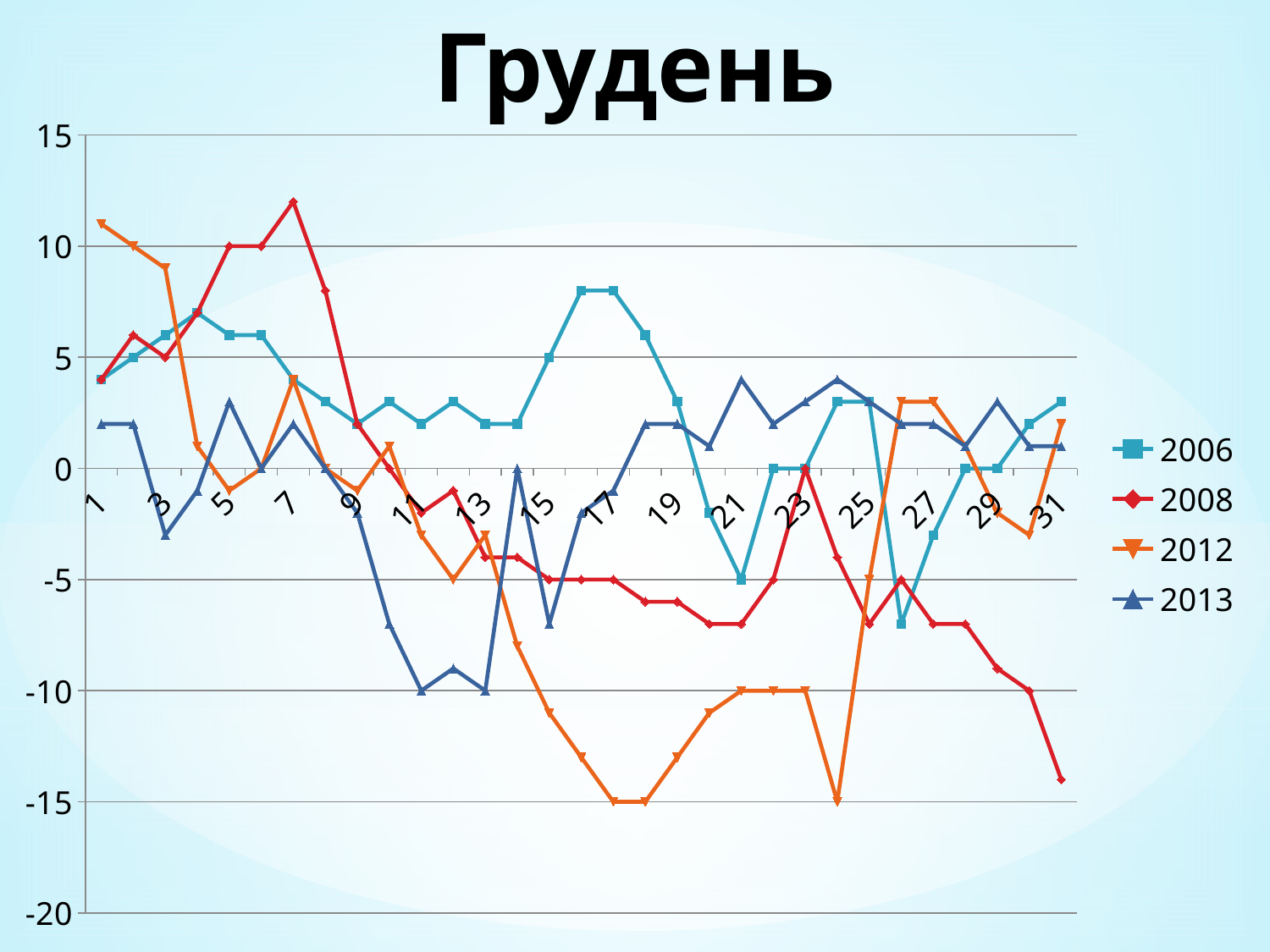
Which series reaches the lowest value on the chart? 2012 On day 1, which series has the larger value, 2012 or 2006? 2012 Is the value for 2006 on day 17 greater or less than 5? greater Is the value for 2012 on day 1 greater or less than 10? greater On day 17, which series has the larger value, 2006 or 2008? 2006 How many series does the legend list? 4 What kind of chart is shown on the slide? line chart Is the value for 2012 on day 17 greater or less than -10? less What is the title of the chart? Грудень Which series reaches the highest value on the chart? 2008